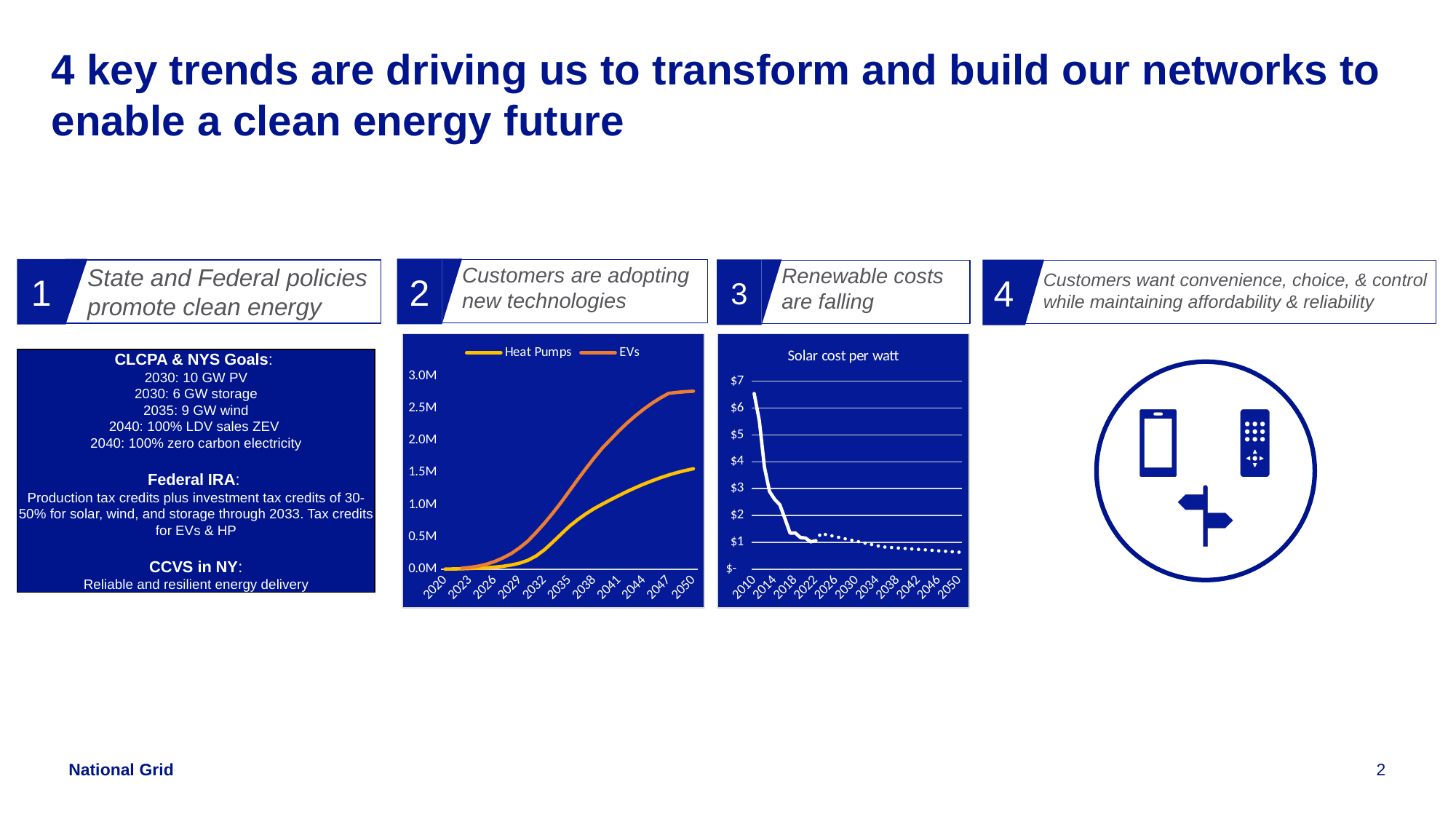
On the left chart (Heat Pumps and EVs), how many series does the legend list? 2 On the left chart (Heat Pumps and EVs), is the value for EVs in 2050 greater or less than 2.5M? greater What kind of chart is the left chart showing Heat Pumps and EVs? line chart On the left chart (Heat Pumps and EVs), what are the two series named in the legend? Heat Pumps and EVs On the left chart (Heat Pumps and EVs), how many year labels are shown on the x axis? 11 On the 'Solar cost per watt' chart, is the value in 2010 greater or less than $6? greater On the left chart (Heat Pumps and EVs), is the value for Heat Pumps in 2035 greater or less than 1.0M? less On the left chart (Heat Pumps and EVs), which series is higher in 2050, Heat Pumps or EVs? EVs On the 'Solar cost per watt' chart, do the values rise or fall from 2010 to 2050? fall On the left chart (Heat Pumps and EVs), do the values rise or fall from 2020 to 2050? rise What is the title of the right chart? Solar cost per watt